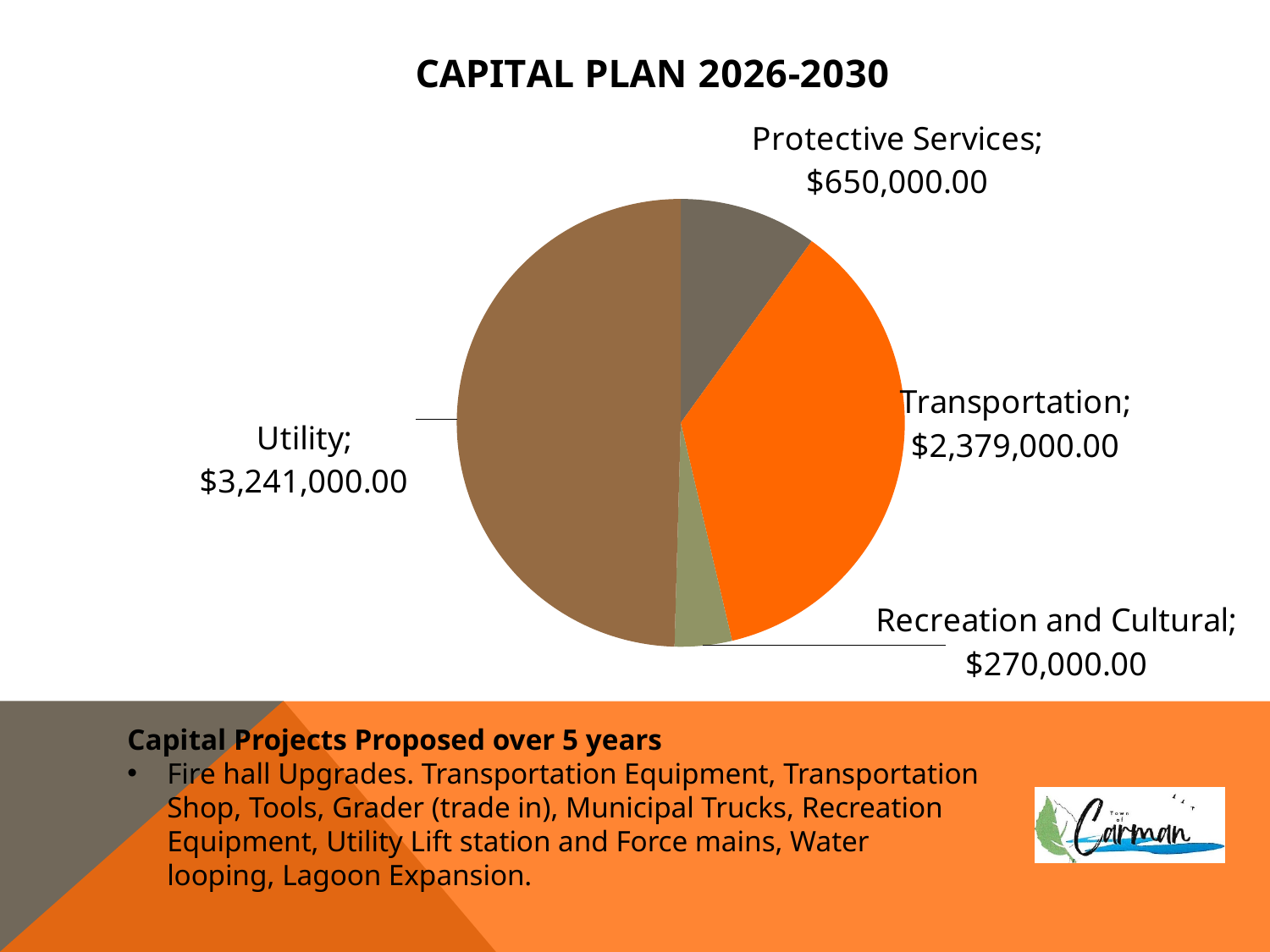
What is the title of the chart? CAPITAL PLAN 2026-2030 What is the difference between the Utility and Transportation values? $862,000.00 Which category has the smallest slice of the pie chart? Recreation and Cultural What is the value for Recreation and Cultural in the pie chart? $270,000.00 What kind of chart is shown on the slide? Pie chart What is the value for Transportation in the pie chart? $2,379,000.00 Which category has the largest slice of the pie chart? Utility How many categories are shown in the pie chart? 4 What is the value for Protective Services in the pie chart? $650,000.00 Which is larger, Transportation or Protective Services? Transportation What is the value for Utility in the pie chart? $3,241,000.00 What is the difference between the Protective Services and Recreation and Cultural values? $380,000.00